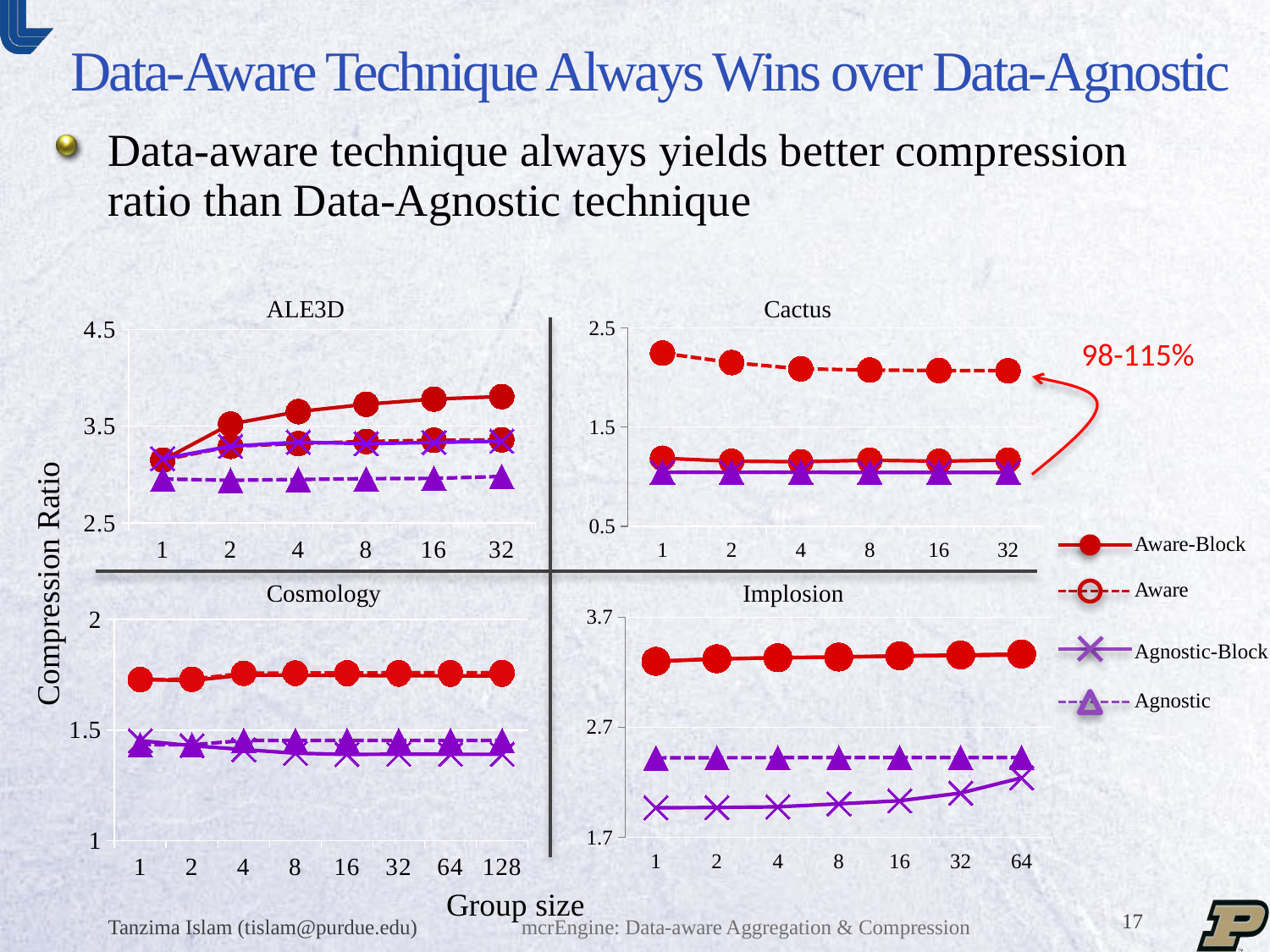
How many group-size points are plotted on the x axis of the Cosmology chart? 8 How many series does the legend list for the charts? 4 What percentage range is annotated next to the Cactus chart? 98-115% In the Implosion chart, does the Agnostic-Block series rise or fall as group size increases? rise In the Implosion chart, is the Agnostic-Block value at group size 1 greater or less than 2.7? less In the ALE3D chart, is the Aware-Block value at group size 32 greater or less than 3.5? greater In the Cactus chart, which series is larger at group size 1, Aware or Aware-Block? Aware In the ALE3D chart, is the Agnostic value at group size 32 greater or less than 3.5? less How many group-size points are plotted on the x axis of the Implosion chart? 7 What kind of chart is the ALE3D chart? line chart In the Cactus chart, does the Aware series rise or fall as group size increases? fall